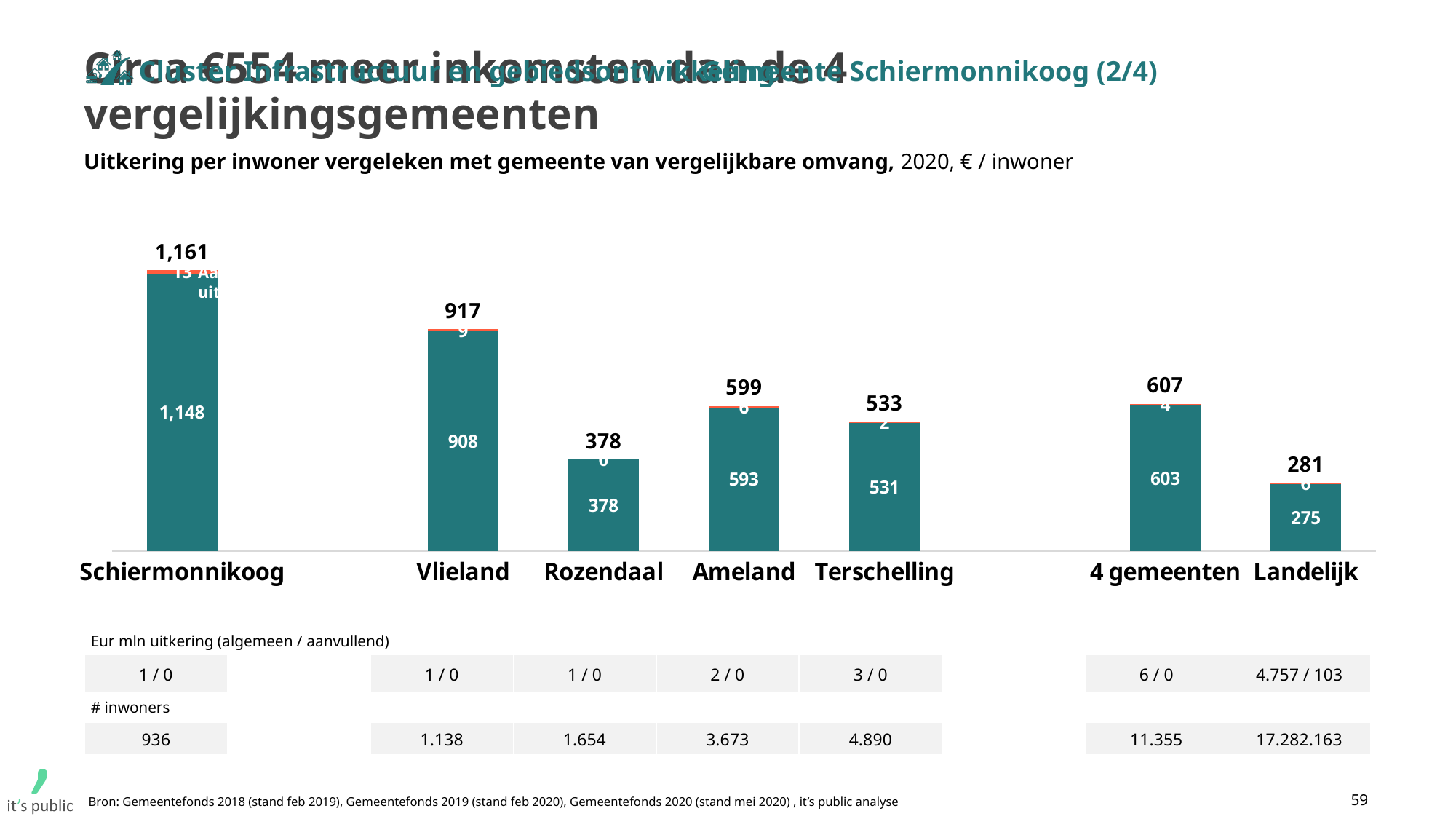
What is the total value shown above the bar for Schiermonnikoog? 1,161 What is the value of the large teal segment of the Ameland bar? 593 Which category has the highest total value? Schiermonnikoog What is the total value shown above the bar for Vlieland? 917 What is the value of the large teal segment of the Rozendaal bar? 378 What is the difference between the total for Schiermonnikoog (1,161) and the total for 4 gemeenten (607)? 554 According to the chart subtitle, in which year and unit are the values shown? 2020, € / inwoner What is the total value shown above the bar for Landelijk? 281 What kind of chart is shown on the slide? Bar chart Which has a larger total value, Ameland or Terschelling? Ameland Which category has the lowest total value? Landelijk How many categories are shown on the x axis of the chart? 7